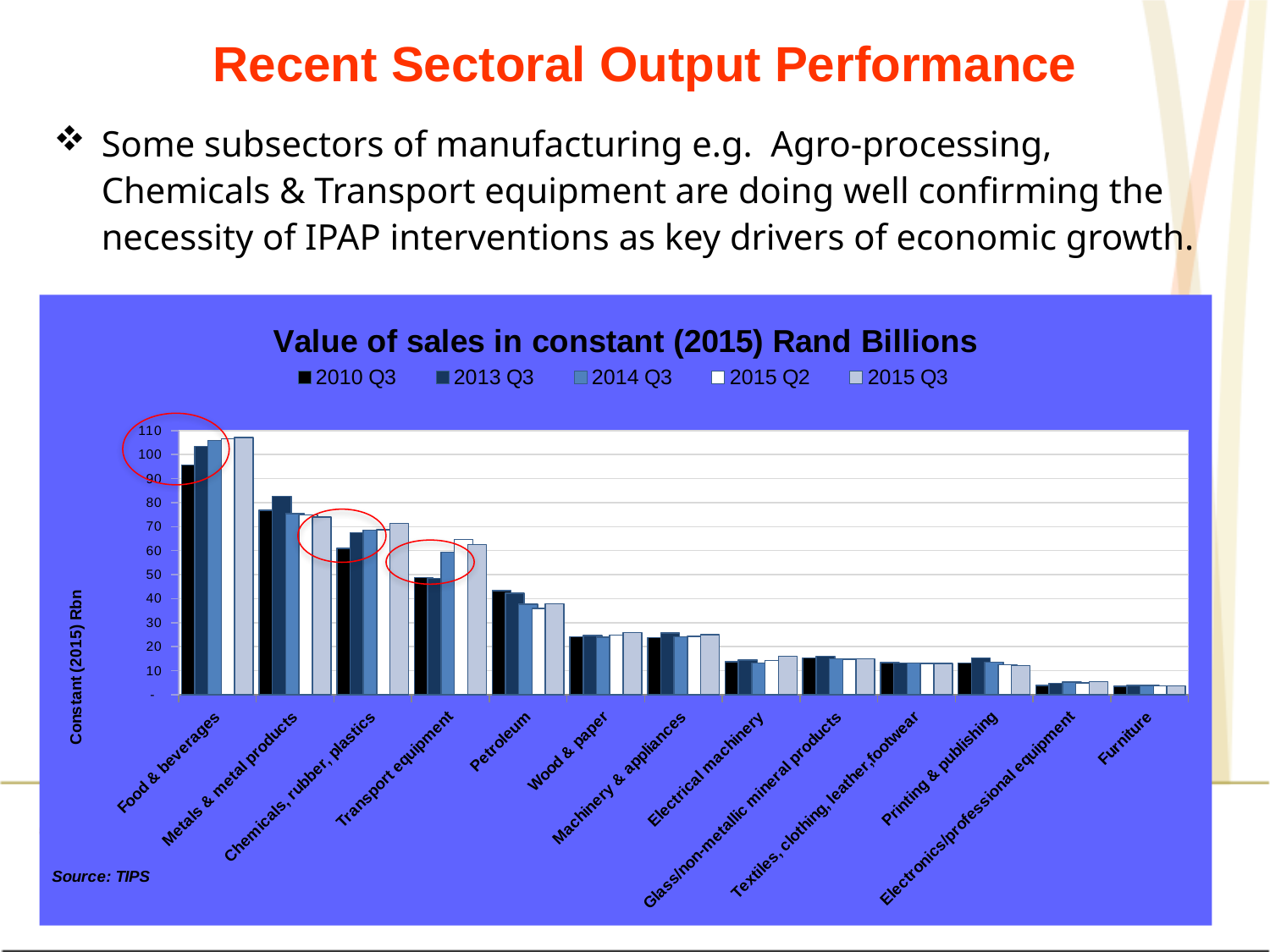
What kind of chart is shown on the slide? Bar chart How many sector categories are shown on the x axis of the chart? 13 Is the 2015 Q3 value for Furniture greater or less than 10? less Do the bar heights generally rise or fall moving from left to right across the sectors? fall How many series does the legend of the chart list? 5 For 2010 Q3, which is larger: Metals & metal products or Chemicals, rubber, plastics? Metals & metal products Is the 2015 Q3 value for Transport equipment greater or less than 50? greater Is the 2010 Q3 value for Food & beverages greater or less than 90? greater Which sector has the highest value of sales in the chart? Food & beverages Which sector has the lowest value of sales in the chart? Furniture What is the title of the chart? Value of sales in constant (2015) Rand Billions